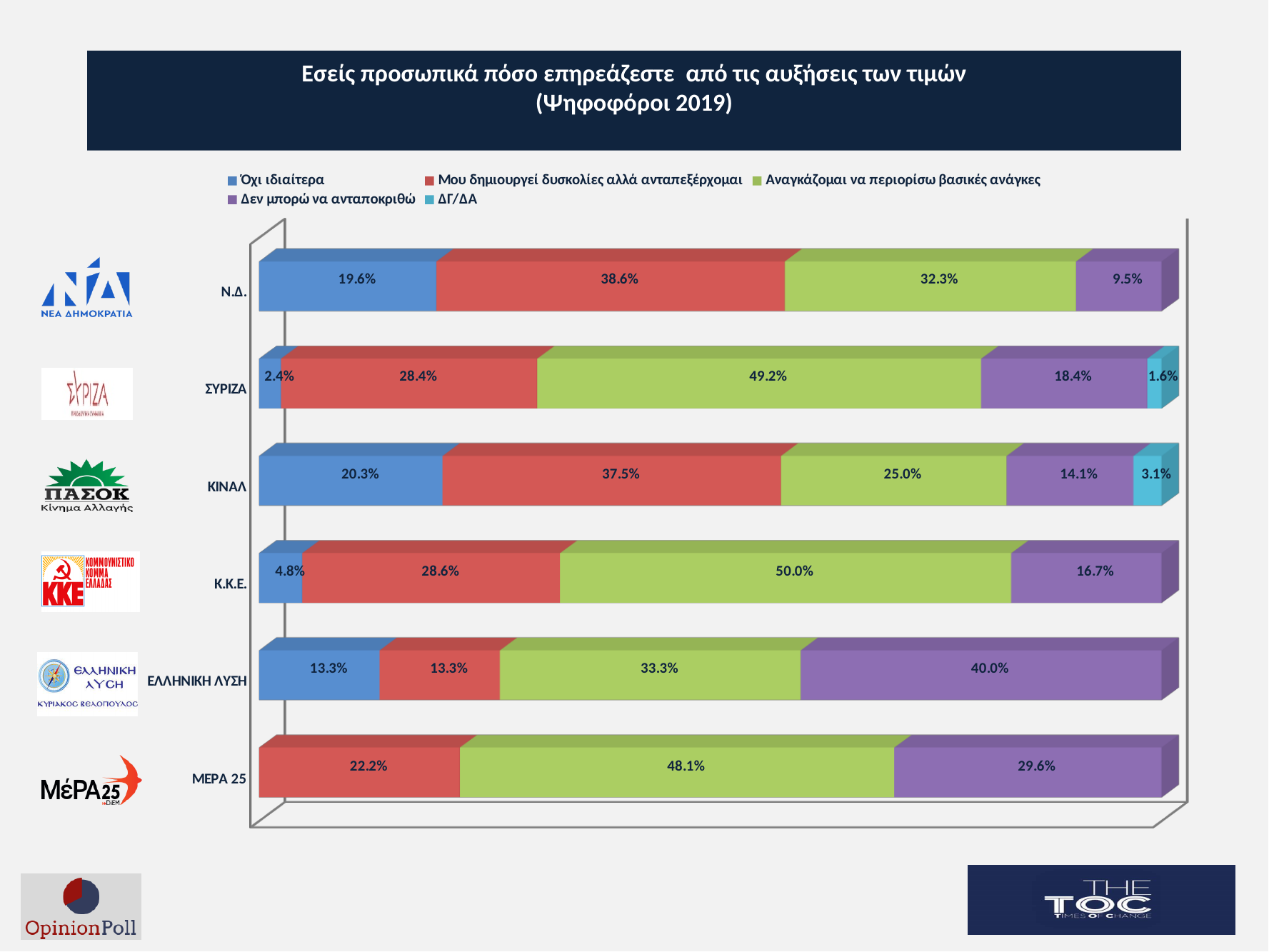
What kind of chart is shown on the slide? Stacked bar chart What is the value of 'Αναγκάζομαι να περιορίσω βασικές ανάγκες' for ΣΥΡΙΖΑ? 49.2% Which is larger: the 'Όχι ιδιαίτερα' value for ΚΙΝΑΛ or for Ν.Δ.? ΚΙΝΑΛ What is the value of 'Μου δημιουργεί δυσκολίες αλλά ανταπεξέρχομαι' for Ν.Δ.? 38.6% What is the difference between the 'Δεν μπορώ να ανταποκριθώ' values for ΜΕΡΑ 25 and Ν.Δ.? 20.1% How many series does the legend list? 5 What is the title of the chart? Εσείς προσωπικά πόσο επηρεάζεστε από τις αυξήσεις των τιμών (Ψηφοφόροι 2019) How many parties (categories) are shown on the chart? 6 What is the value of 'Δεν μπορώ να ανταποκριθώ' for ΕΛΛΗΝΙΚΗ ΛΥΣΗ? 40.0% Which party has the highest value for 'Αναγκάζομαι να περιορίσω βασικές ανάγκες'? Κ.Κ.Ε. What is the value of 'ΔΓ/ΔΑ' for ΚΙΝΑΛ? 3.1% Which party has the lowest value for 'Όχι ιδιαίτερα' among those with a labelled value? ΣΥΡΙΖΑ